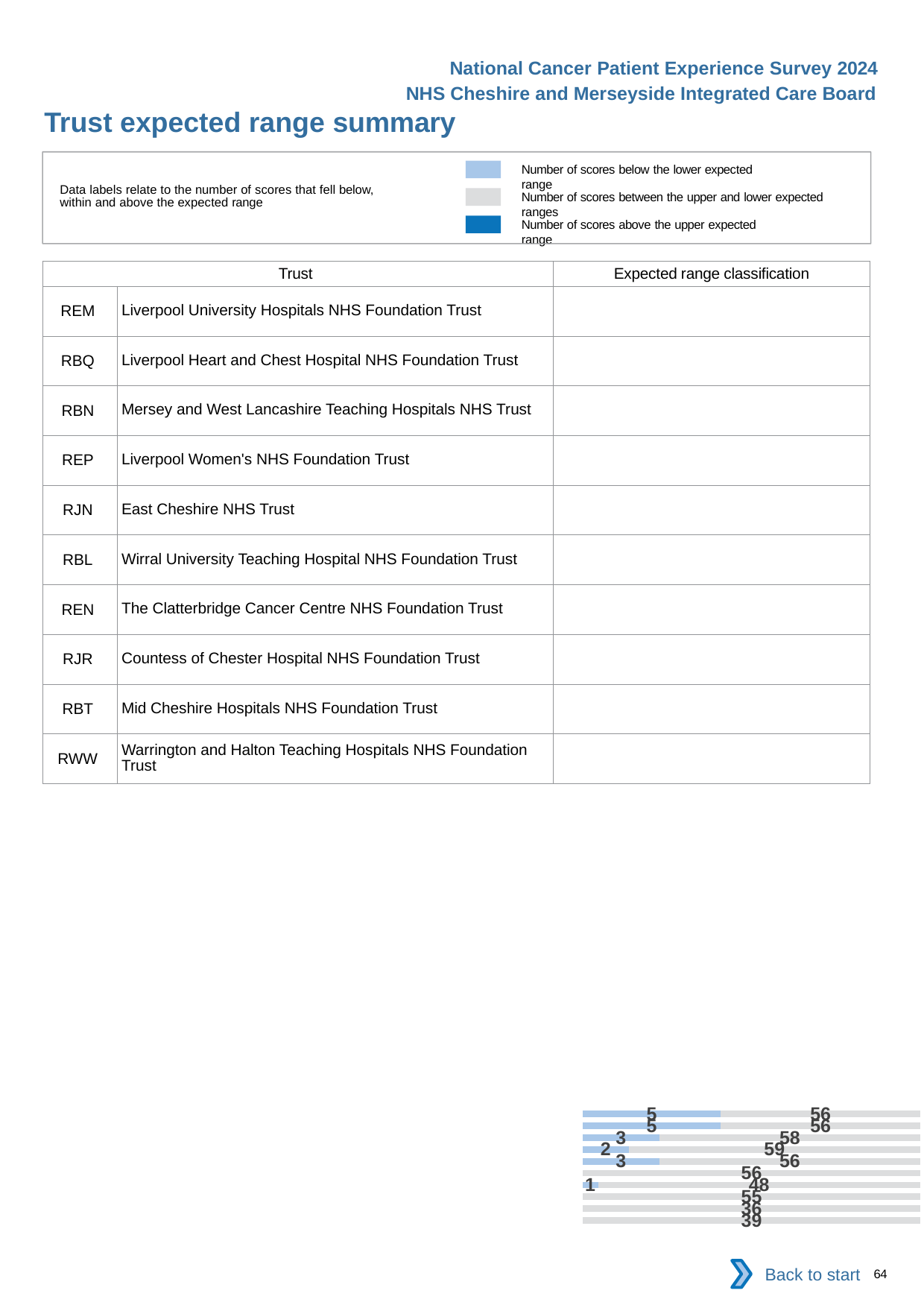
In the chart at the bottom right, what is the light blue (below expected range) value labelled on the topmost bar? 5 In the chart at the bottom right, is the grey value on the topmost bar larger or smaller than the grey value on the bottommost bar? larger In the chart at the bottom right, what is the light blue value labelled on the bar with grey value 48? 1 According to the legend, what does the dark blue colour represent? Number of scores above the upper expected range What kind of chart is shown at the bottom right of the slide? bar chart In the chart at the bottom right, what is the lowest grey (within expected range) value labelled on any bar? 36 According to the legend, what does the light blue colour represent? Number of scores below the lower expected range In the chart at the bottom right, what is the total of the topmost stacked bar? 61 In the chart at the bottom right, what is the highest grey (within expected range) value labelled on any bar? 59 How many bars are plotted in the chart at the bottom right of the slide? 10 How many series does the legend at the top of the slide list? 3 In the chart at the bottom right, what is the grey (within expected range) value labelled on the topmost bar? 56